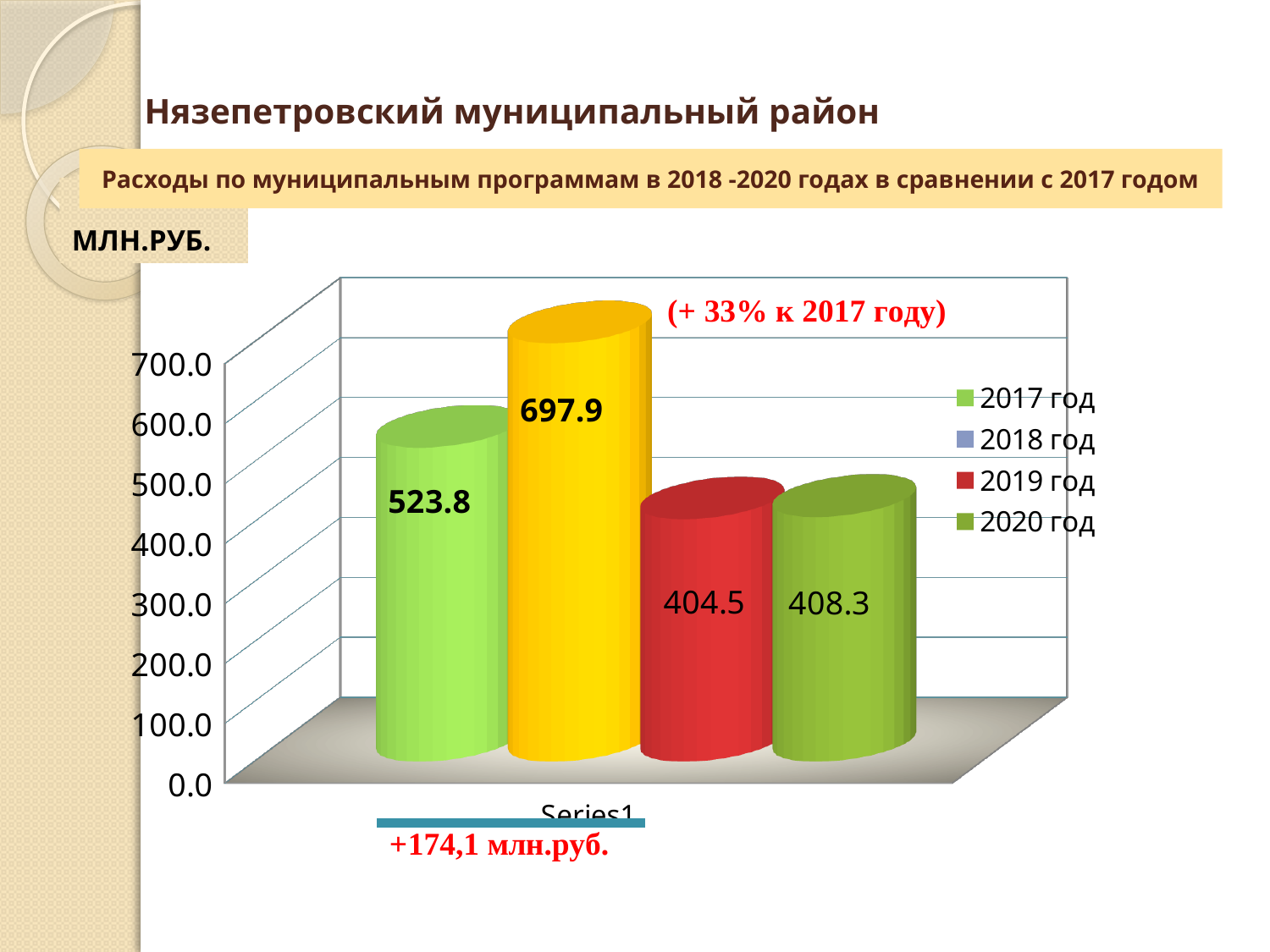
What is the value for 2019 год? 404.5 Which year has the highest value? 2018 год What kind of chart is shown on the slide? bar chart What is the difference between the values for 2020 год and 2019 год? 3.8 What is the value for 2018 год? 697.9 What is the value for 2020 год? 408.3 What is the difference between the values for 2018 год and 2017 год? 174.1 How many series does the legend list? 4 What is the value for 2017 год? 523.8 Which is larger, the value for 2017 год or the value for 2020 год? 2017 год Which year has the lowest value? 2019 год What unit is stated for the values on the chart? МЛН.РУБ.